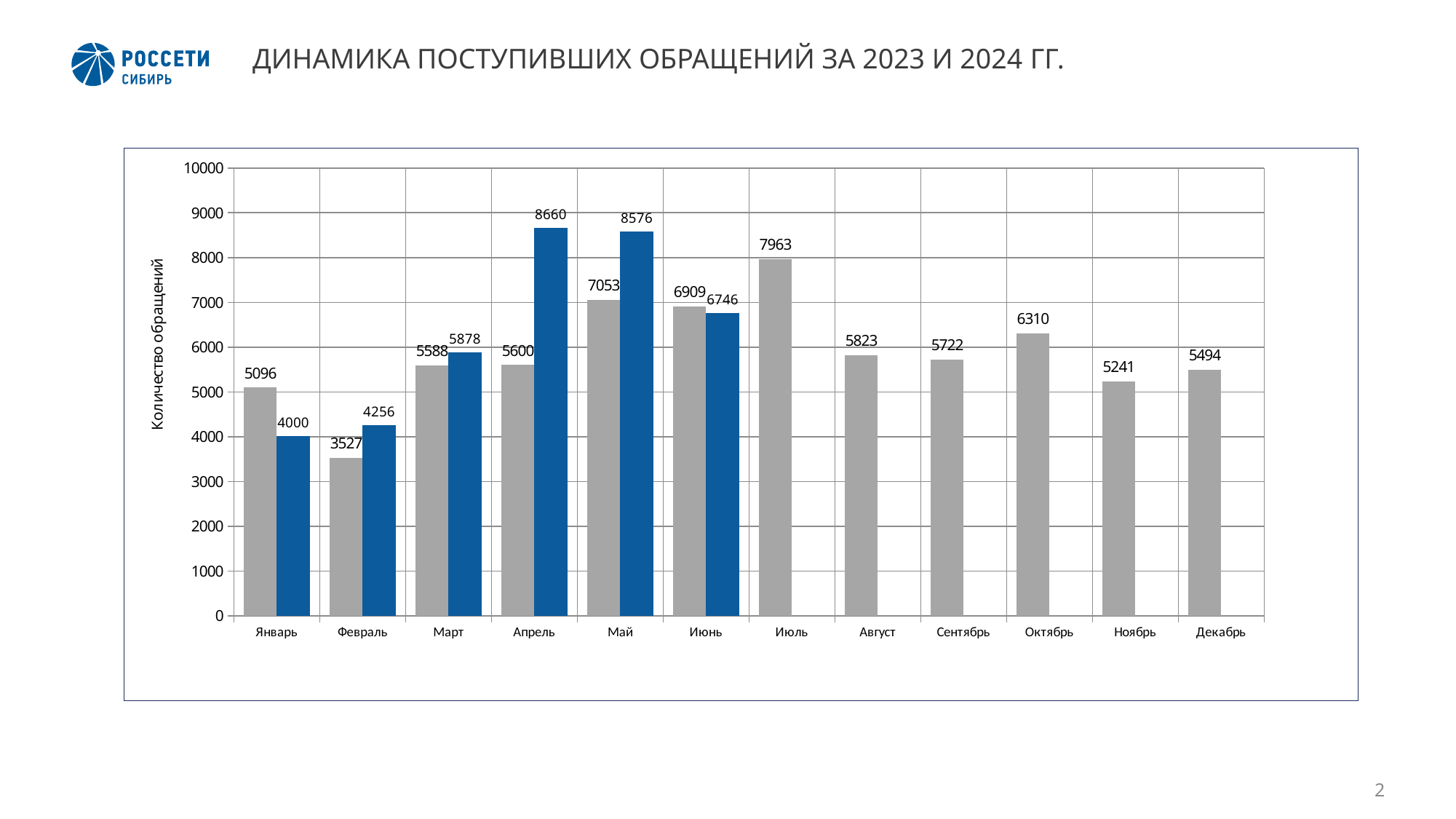
Which month has the lowest grey bar? Февраль How many blue bars are there in the chart? 6 What is the difference between the grey bar and the blue bar for Январь? 1096 What is the value of the blue bar for Апрель? 8660 What is the value of the grey bar for Июль? 7963 Which month has the highest blue bar? Апрель What is the title of the vertical axis? Количество обращений Which month has the highest grey bar? Июль What kind of chart is shown on the slide? bar chart How many months are shown on the x axis? 12 For Июнь, which bar is larger, the grey one or the blue one? the grey one What is the difference between the blue bar and the grey bar for Май? 1523